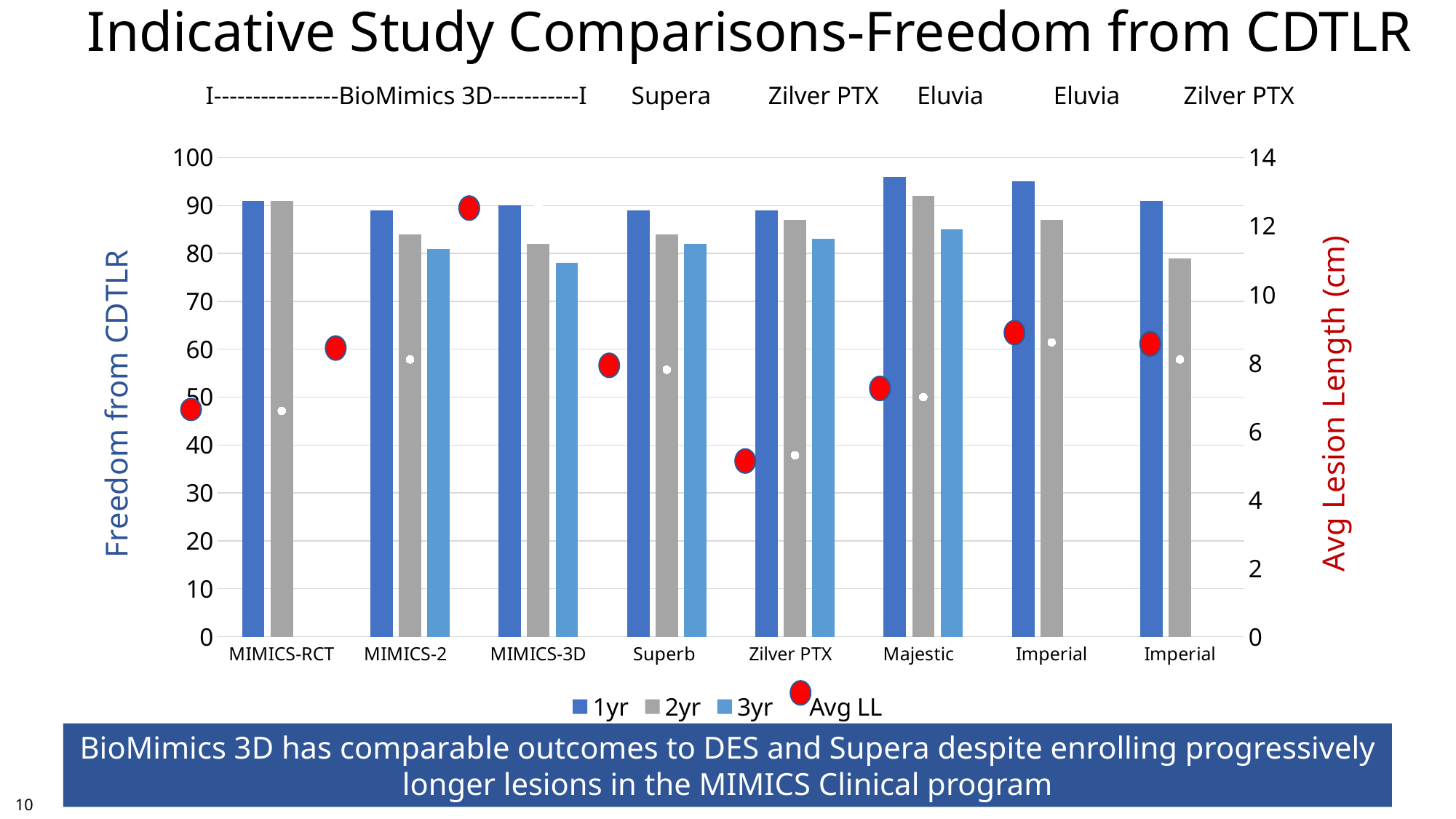
What is the title of the right-hand vertical axis? Avg Lesion Length (cm) Is the Avg LL value for MIMICS-3D greater or less than 12? greater Does the Avg LL value rise or fall across MIMICS-RCT, MIMICS-2 and MIMICS-3D? rise How many series does the chart legend list? 4 How many categories have a 3yr bar? 5 Is the Avg LL value for Zilver PTX greater or less than 6? less How many categories are shown along the x axis of the chart? 8 Is the 3yr value for MIMICS-3D greater or less than 80? less Which category has the lowest Avg LL value? Zilver PTX What kind of chart is shown on the slide? combination chart (bars with markers) Which category has the highest Avg LL value? MIMICS-3D Which is larger, the 2yr value for Majestic or the 2yr value for Zilver PTX? Majestic